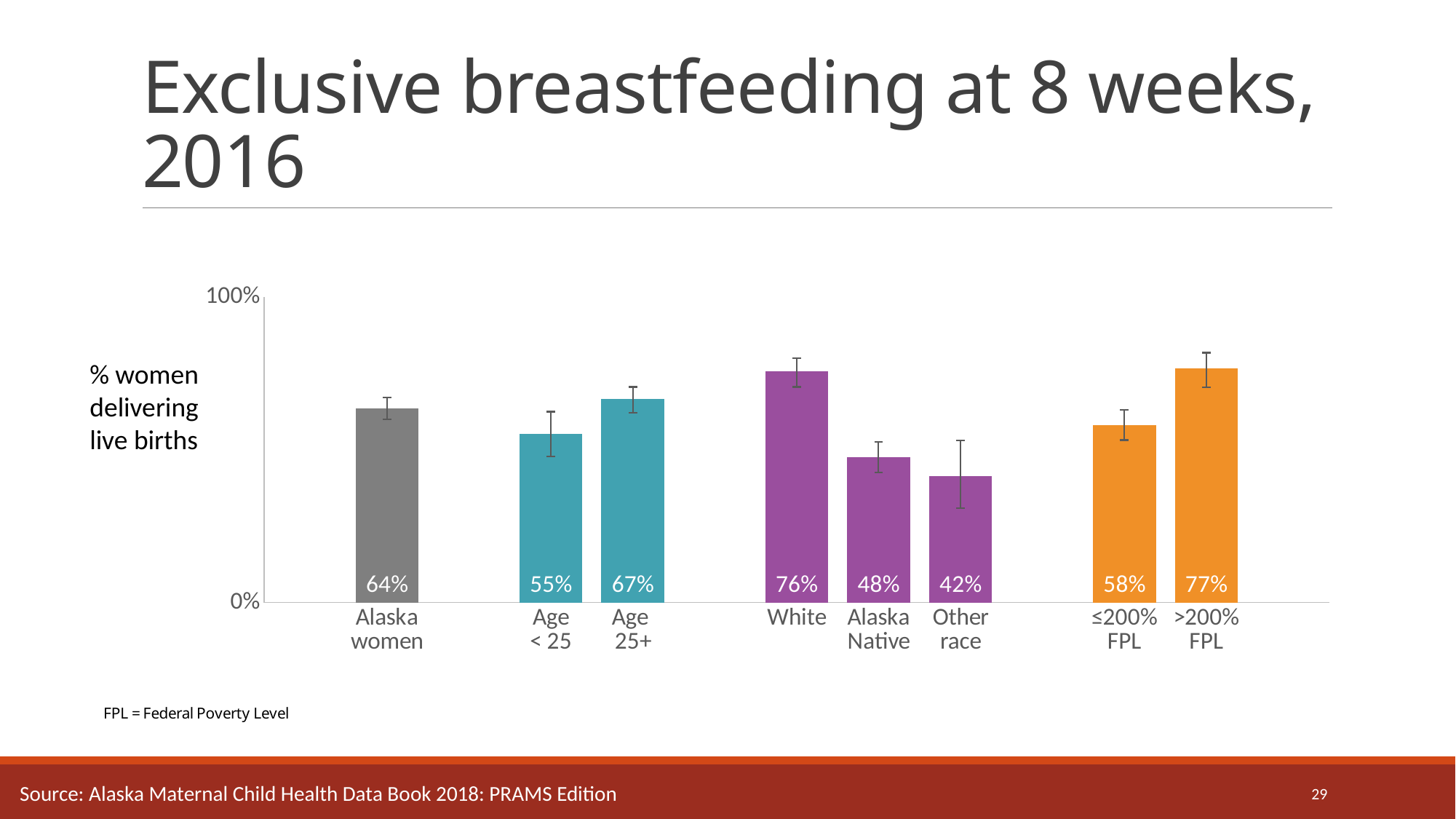
What is the title of the chart? Exclusive breastfeeding at 8 weeks, 2016 How many bars are shown in the chart? 8 Which category has the highest value? >200% FPL What is the value for >200% FPL? 77% What is the value for Alaska women? 64% Which category has the lowest value? Other race What is the value for Age < 25? 55% What is the difference between the values for White and Alaska Native? 28% What is the difference between the values for Age 25+ and Age < 25? 12% What is the value for Alaska Native? 48% What kind of chart is shown on the slide? Bar chart Which is larger, the value for ≤200% FPL or the value for Alaska women? Alaska women